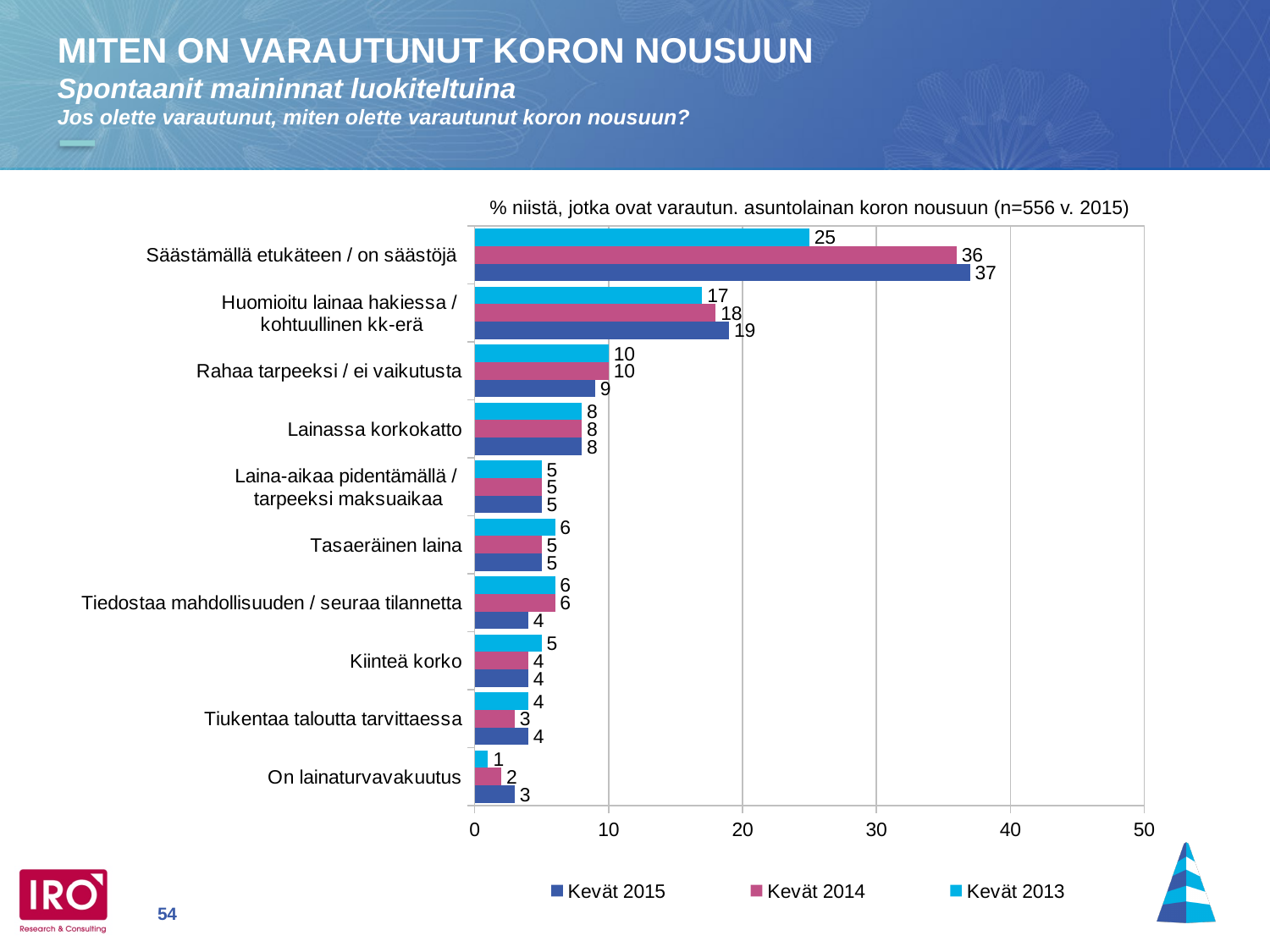
Which series is shown in dark blue according to the legend? Kevät 2015 What is the difference between the Kevät 2015 and Kevät 2013 values for "Säästämällä etukäteen / on säästöjä"? 12 Which category has the lowest Kevät 2013 value? On lainaturvavakuutus Is the Kevät 2014 value for "Säästämällä etukäteen / on säästöjä" greater or less than 30? greater What kind of chart is shown on the slide? Bar chart Which category has the highest Kevät 2015 value? Säästämällä etukäteen / on säästöjä What is the Kevät 2015 value for "Säästämällä etukäteen / on säästöjä"? 37 How many categories are shown on the chart? 10 For "Tiedostaa mahdollisuuden / seuraa tilannetta", which is larger: the Kevät 2014 value or the Kevät 2015 value? Kevät 2014 How many series does the legend list? 3 What is the Kevät 2014 value for "On lainaturvavakuutus"? 2 What is the Kevät 2013 value for "Huomioitu lainaa hakiessa / kohtuullinen kk-erä"? 17